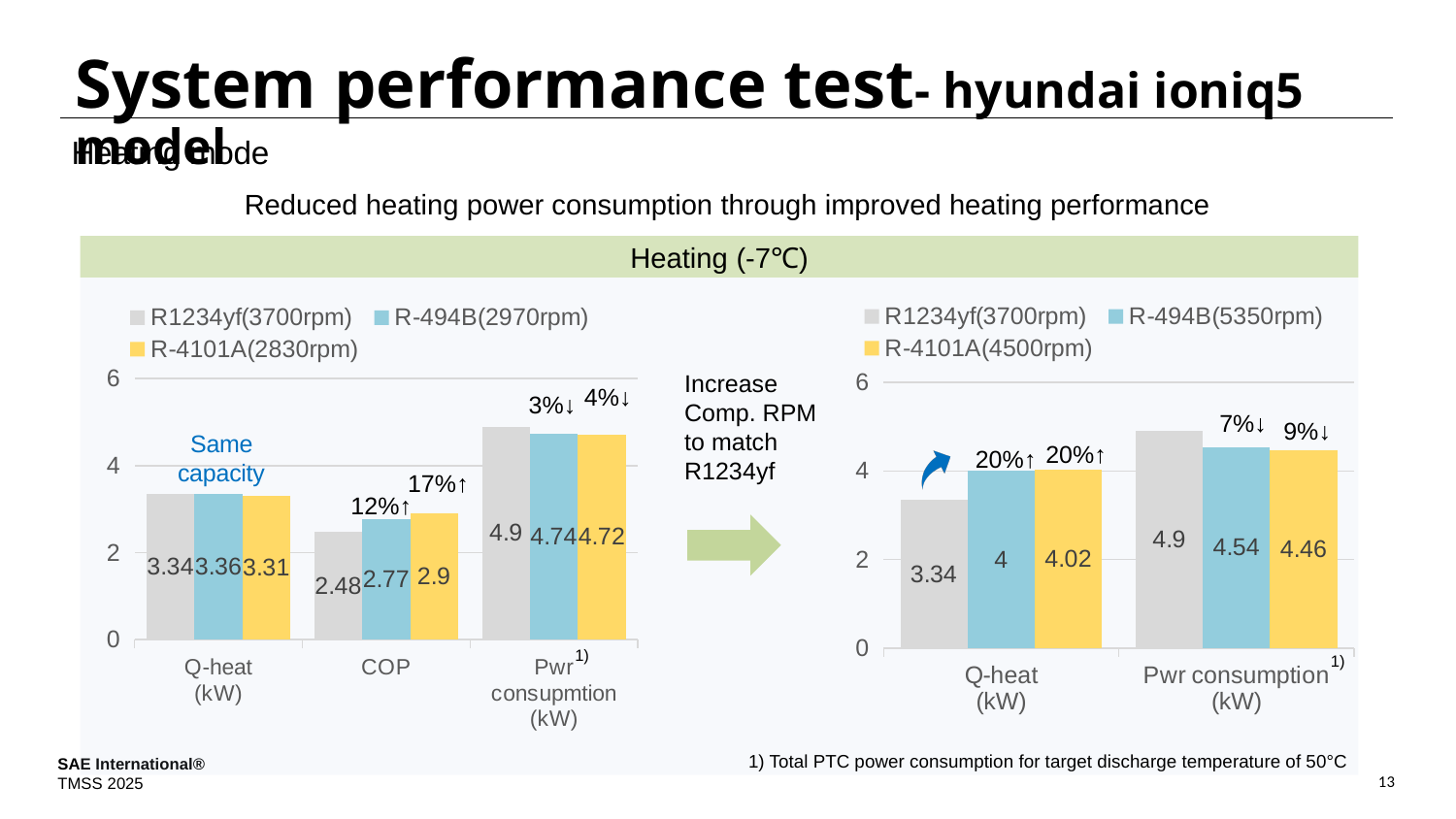
In the right chart, what is the Pwr consumption (kW) value for R-494B(5350rpm)? 4.54 In the right chart, which series has the lowest Pwr consumption (kW)? R-4101A(4500rpm) What type of chart is the right chart? Bar chart How many categories are shown on the x axis of the left chart? 3 In the left chart, which series has the highest COP? R-4101A(2830rpm) In the right chart, what is the difference in Pwr consumption (kW) between R1234yf(3700rpm) and R-4101A(4500rpm)? 0.44 How many series does the legend of the right chart list? 3 In the left chart, what is the difference in COP between R-4101A(2830rpm) and R1234yf(3700rpm)? 0.42 In the right chart, which is larger for Q-heat (kW): R1234yf(3700rpm) or R-494B(5350rpm)? R-494B(5350rpm) In the left chart, what is the COP value for R-494B(2970rpm)? 2.77 In the right chart, what is the Q-heat (kW) value for R-4101A(4500rpm)? 4.02 In the left chart, what is the Pwr consumption (kW) value for R1234yf(3700rpm)? 4.9